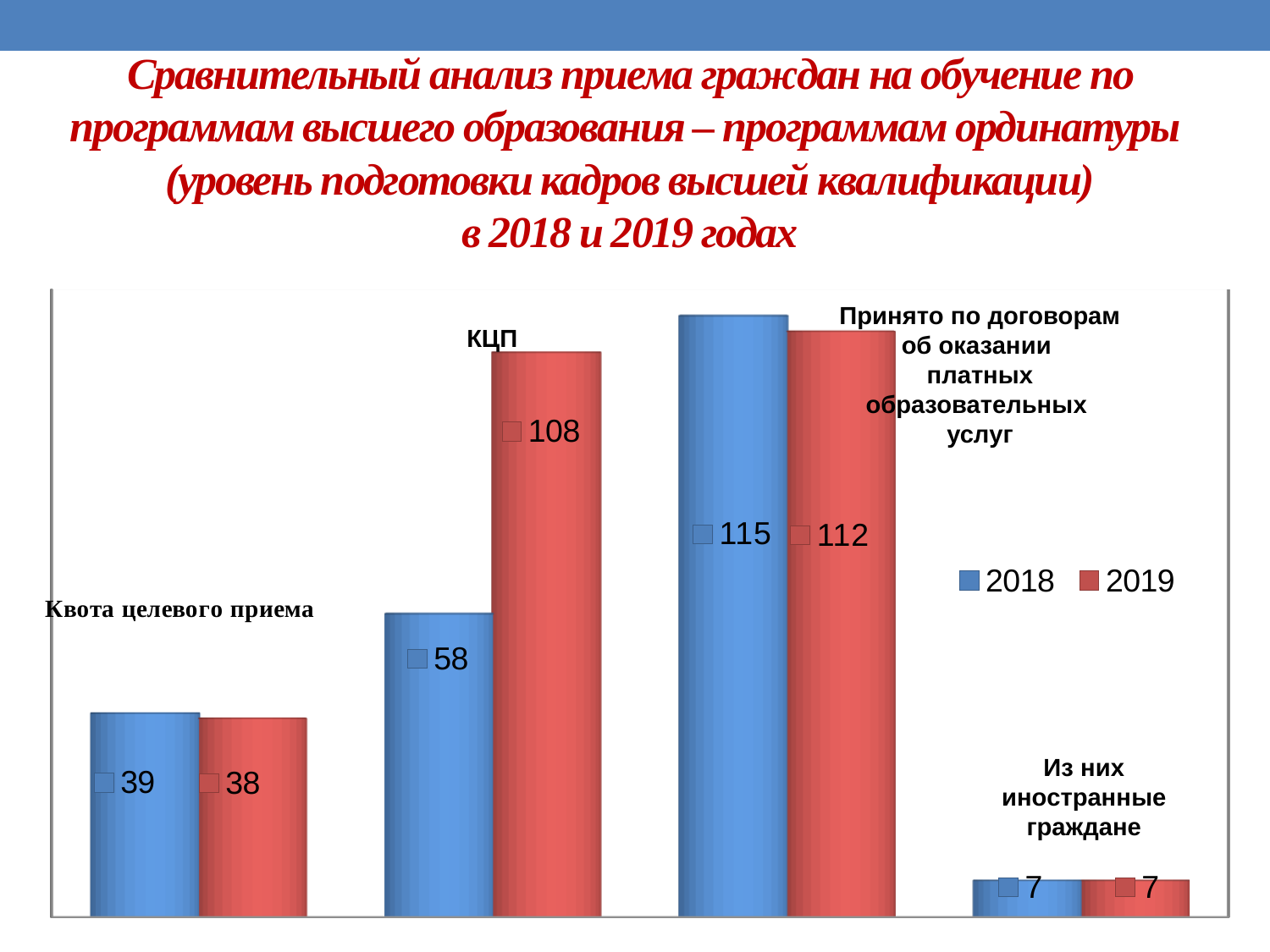
Which category has the lowest value for 2019? Из них иностранные граждане What is the value for 2019 in the category "Принято по договорам об оказании платных образовательных услуг"? 112 How many series does the legend list? 2 Which category has the highest value for 2018? Принято по договорам об оказании платных образовательных услуг What is the value for 2018 in the category "Квота целевого приема"? 39 Which colour represents the 2019 series in the legend? Red What is the value for 2018 in the category "КЦП"? 58 How many categories are shown on the chart? 4 What kind of chart is shown on the slide? Bar chart Which is larger in the category "Принято по договорам об оказании платных образовательных услуг": the 2018 value or the 2019 value? 2018 What is the difference between the 2019 and 2018 values in the category "КЦП"? 50 What is the value for 2019 in the category "КЦП"? 108